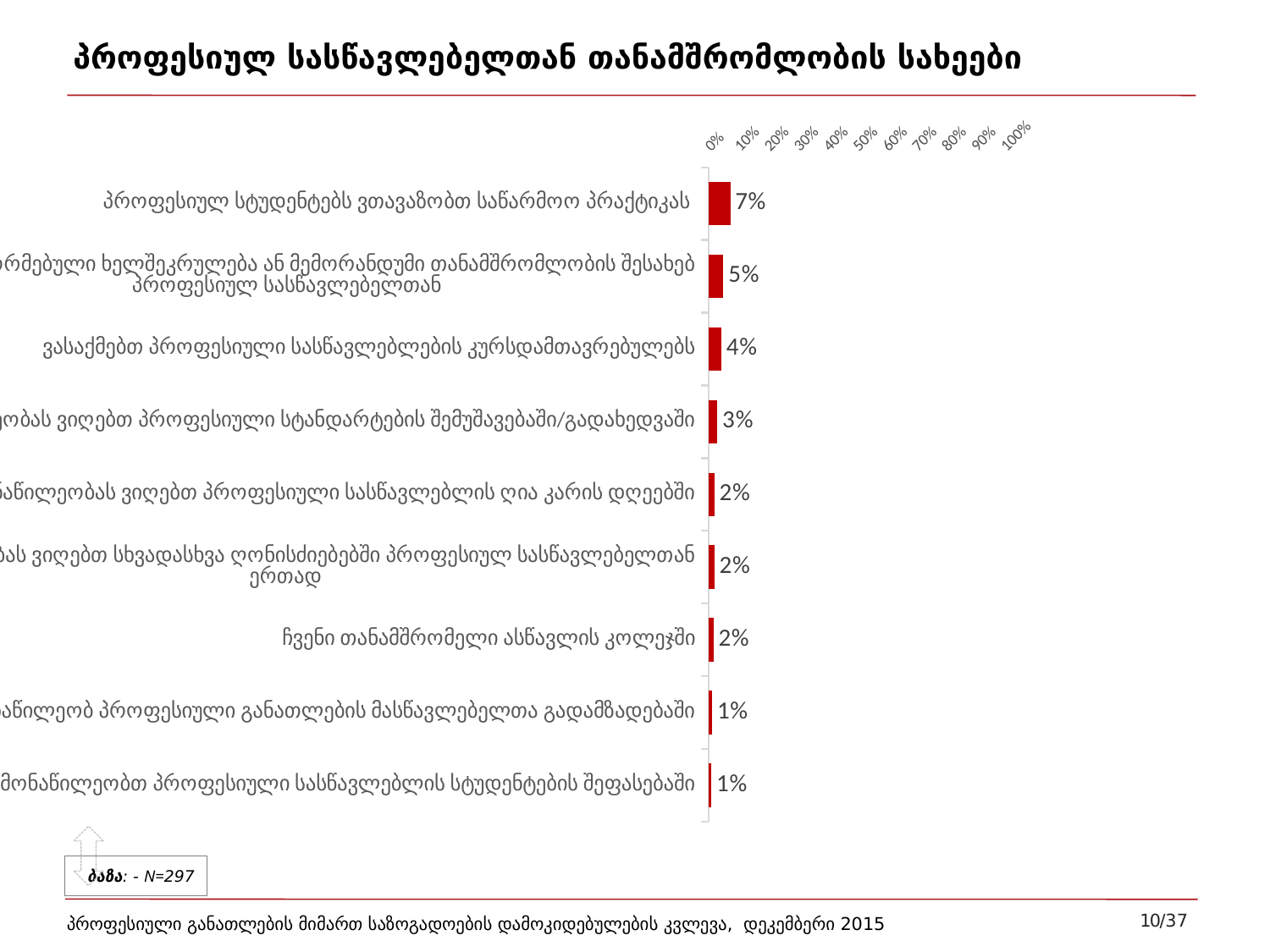
Is the value for "პროფესიულ სტუდენტებს ვთავაზობთ საწარმოო პრაქტიკას" greater or less than 10%? less What is the lowest value shown in the chart? 1% Which category has the highest value in the chart? პროფესიულ სტუდენტებს ვთავაზობთ საწარმოო პრაქტიკას What is the highest value shown in the chart? 7% What is the title of the slide? პროფესიულ სასწავლებელთან თანამშრომლობის სახეები Which is larger: the value for "ვასაქმებთ პროფესიული სასწავლებლების კურსდამთავრებულებს" or the value for "ჩვენი თანამშრომელი ასწავლის კოლეჯში"? ვასაქმებთ პროფესიული სასწავლებლების კურსდამთავრებულებს What is the value for "პროფესიულ სტუდენტებს ვთავაზობთ საწარმოო პრაქტიკას"? 7% What type of chart is shown on the slide? bar chart What is the value for "ჩვენი თანამშრომელი ასწავლის კოლეჯში"? 2% What is the value for "ვასაქმებთ პროფესიული სასწავლებლების კურსდამთავრებულებს"? 4% What is the difference between the value for "პროფესიულ სტუდენტებს ვთავაზობთ საწარმოო პრაქტიკას" and the value for "ვასაქმებთ პროფესიული სასწავლებლების კურსდამთავრებულებს"? 3% How many categories (bars) are shown in the chart? 9